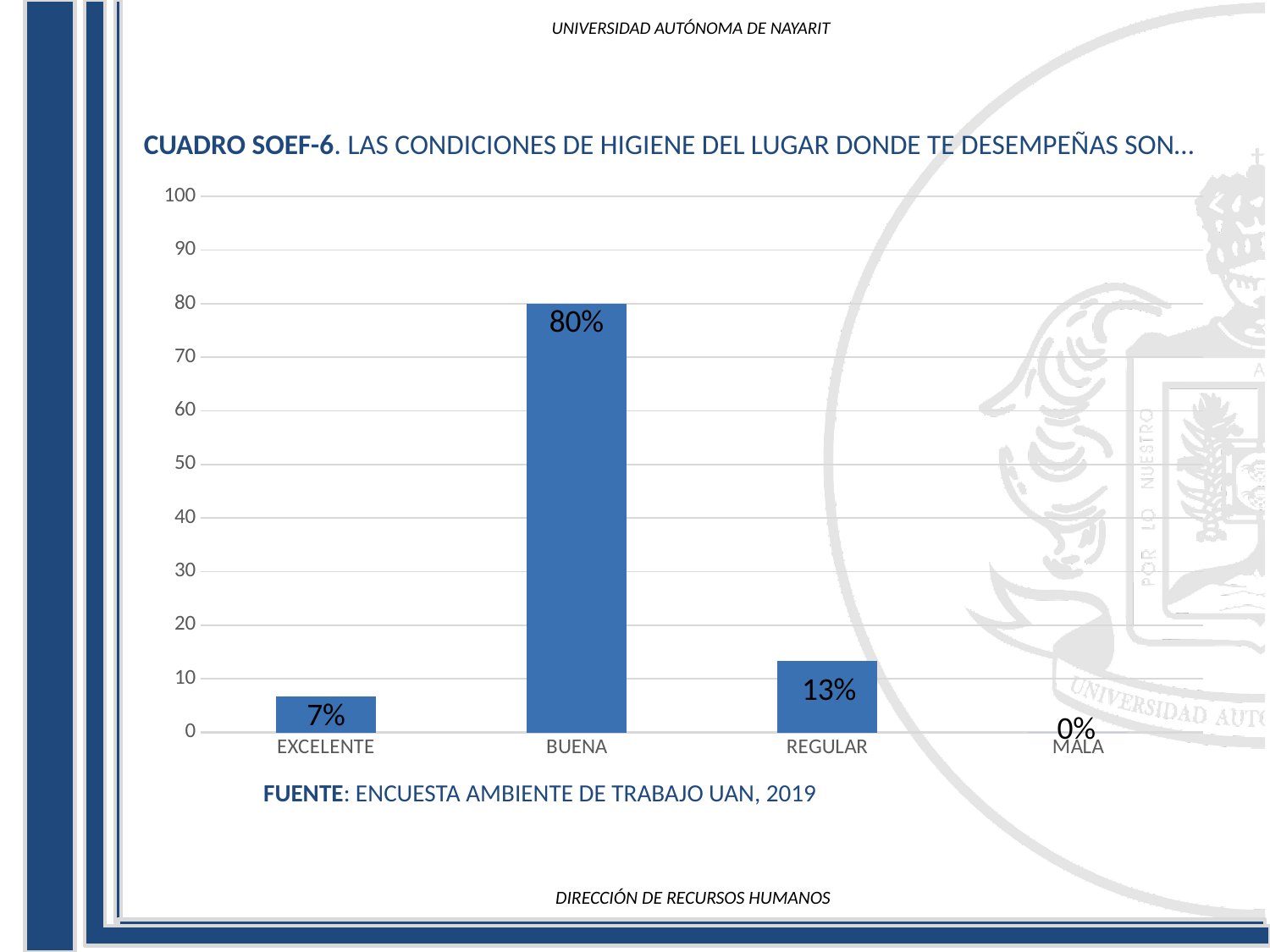
Is the value for BUENA greater or less than 50? greater What is the difference between the values for BUENA and REGULAR? 67% What is the value for EXCELENTE? 7% What is the value for MALA? 0% What is the value for REGULAR? 13% Which category has the highest value? BUENA What is the value for BUENA? 80% What is the difference between the values for REGULAR and EXCELENTE? 6% Which category has the lowest value? MALA How many categories are shown on the x axis? 4 What kind of chart is shown on the slide? bar chart Which is larger, the value for REGULAR or the value for EXCELENTE? REGULAR